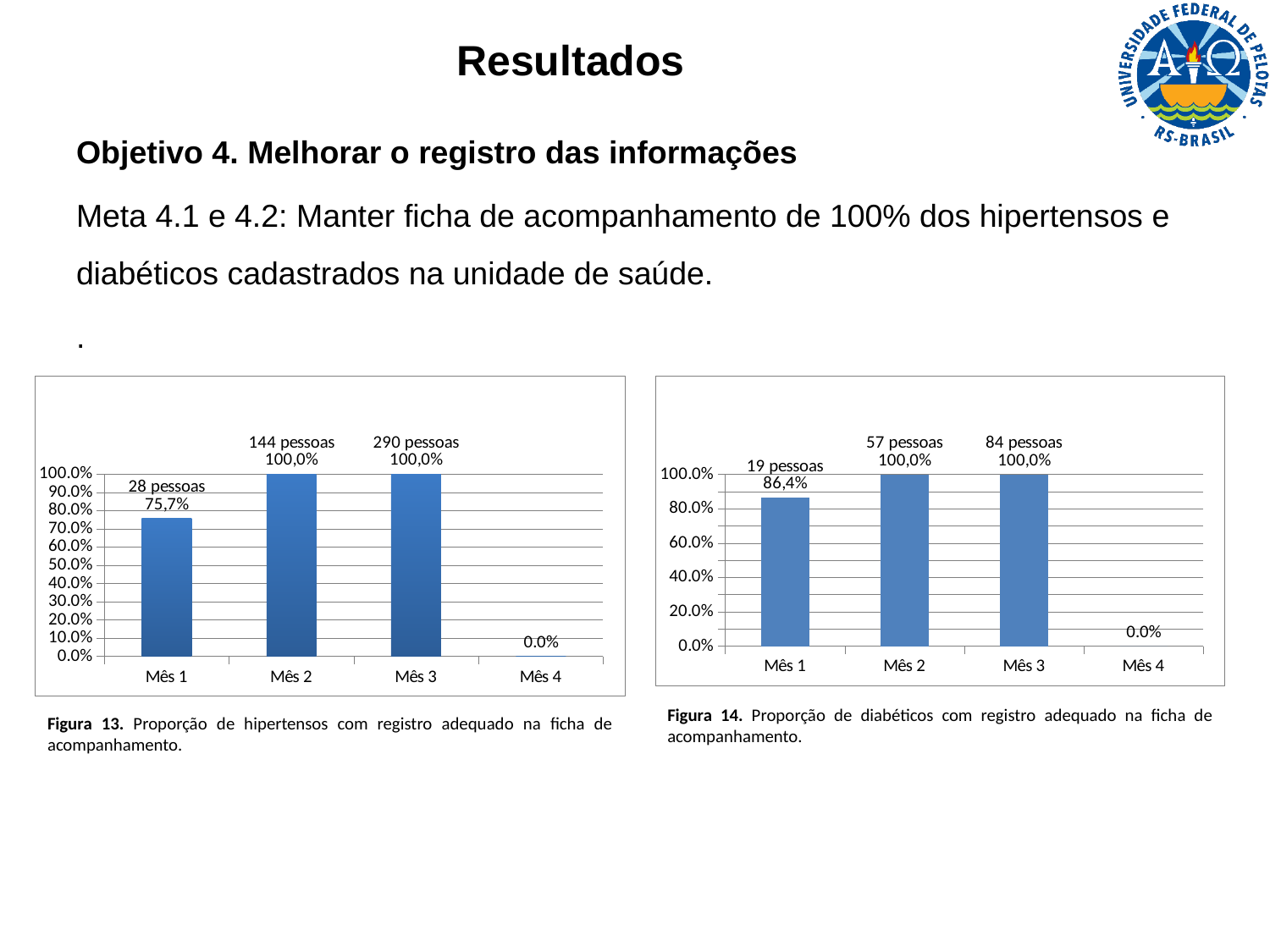
In the right chart (Figura 14, diabéticos), what percentage is shown for Mês 1? 86,4% In the right chart (Figura 14, diabéticos), how many people are labelled for Mês 3? 84 pessoas In the left chart (Figura 13, hipertensos), how many people are labelled for Mês 3? 290 pessoas In the left chart (Figura 13, hipertensos), what value is shown for Mês 4? 0.0% In the right chart (Figura 14, diabéticos), is the value for Mês 1 greater or less than Mês 2? less In the left chart (Figura 13, hipertensos), what is the difference in percentage between Mês 2 and Mês 1? 24,3% How many months (categories) are shown on the x axis of the left chart (Figura 13)? 4 In the left chart (Figura 13, hipertensos), what percentage is shown for Mês 1? 75,7% In the left chart (Figura 13, hipertensos), how many people are labelled for Mês 2? 144 pessoas In the right chart (Figura 14, diabéticos), how many people are labelled for Mês 2? 57 pessoas What type of chart is the right chart (Figura 14, diabéticos)? Bar chart In the right chart (Figura 14, diabéticos), which month has the lowest value? Mês 4